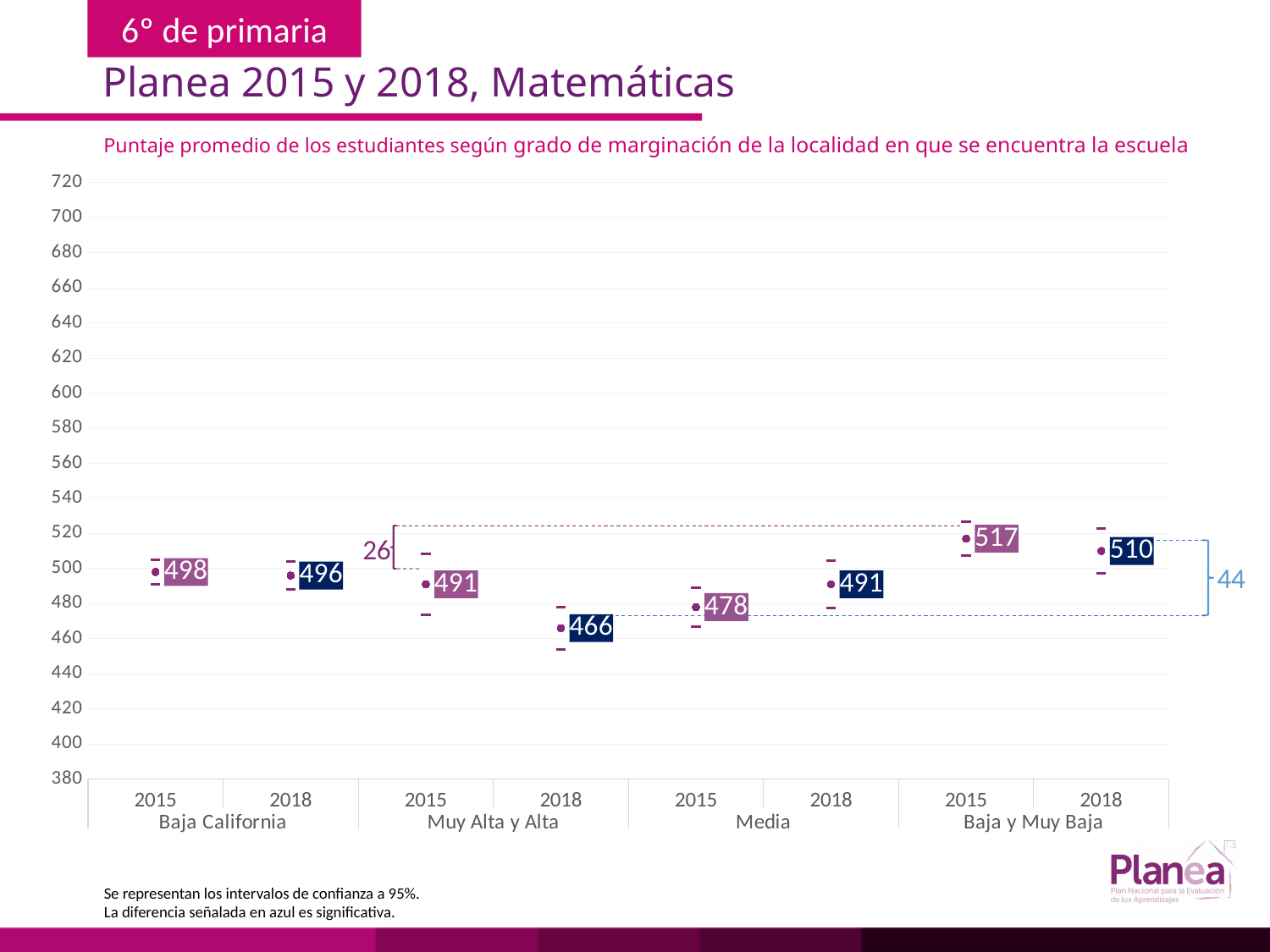
How many data points are plotted on the chart? 8 What is the 2015 value for Baja y Muy Baja? 517 Which group and year has the highest plotted value? Baja y Muy Baja, 2015 What is the difference between the 2015 and 2018 values for Muy Alta y Alta? 25 What is the title of the chart? Puntaje promedio de los estudiantes según grado de marginación de la localidad en que se encuentra la escuela What is the 2018 value for Media? 491 Does the value for Media rise or fall from 2015 to 2018? rise What is the 2015 value for Baja California? 498 Which group and year has the lowest plotted value? Muy Alta y Alta, 2018 Which is larger, the 2015 value for Media or the 2018 value for Media? 2018 (491) What is the difference between the 2018 values for Baja y Muy Baja and Muy Alta y Alta? 44 What is the 2018 value for Muy Alta y Alta? 466